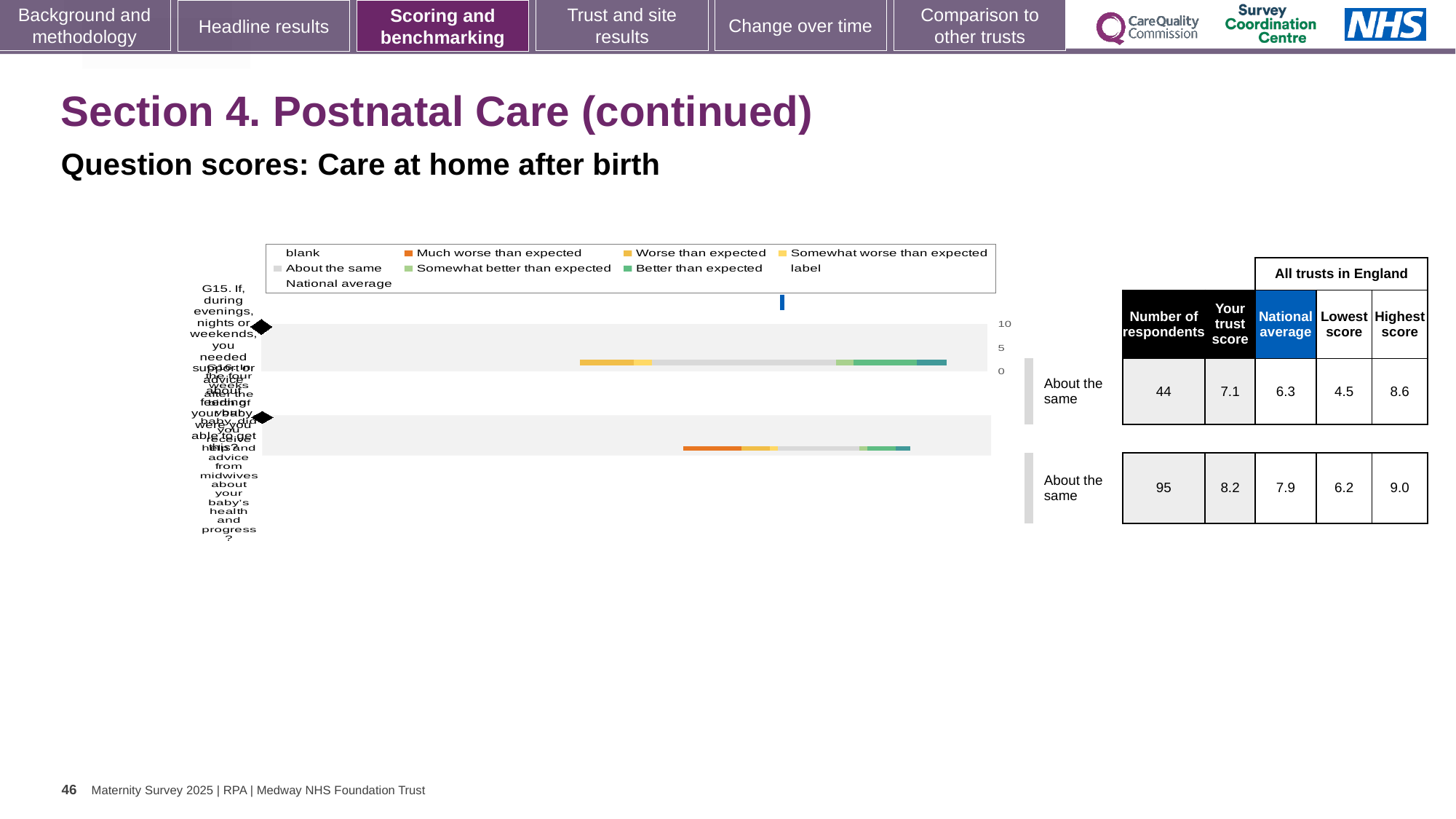
What kind of chart is shown on the slide? Bar chart Which row has the higher trust score, the top row or the bottom row? Bottom row What is the number of respondents for the top row of the chart? 44 What benchmark category is shown for both rows of the chart? About the same What is the trust score for the top row of the chart? 7.1 What is the lowest score in England for the bottom row of the chart? 6.2 What is the national average for the top row of the chart? 6.3 What colour represents 'Much worse than expected' in the legend? Orange By how much does the trust score for the top row exceed its national average? 0.8 How many question rows are plotted in the chart? 2 What is the highest score in England for the bottom row of the chart? 9.0 What is the difference between the highest and lowest scores for the bottom row? 2.8